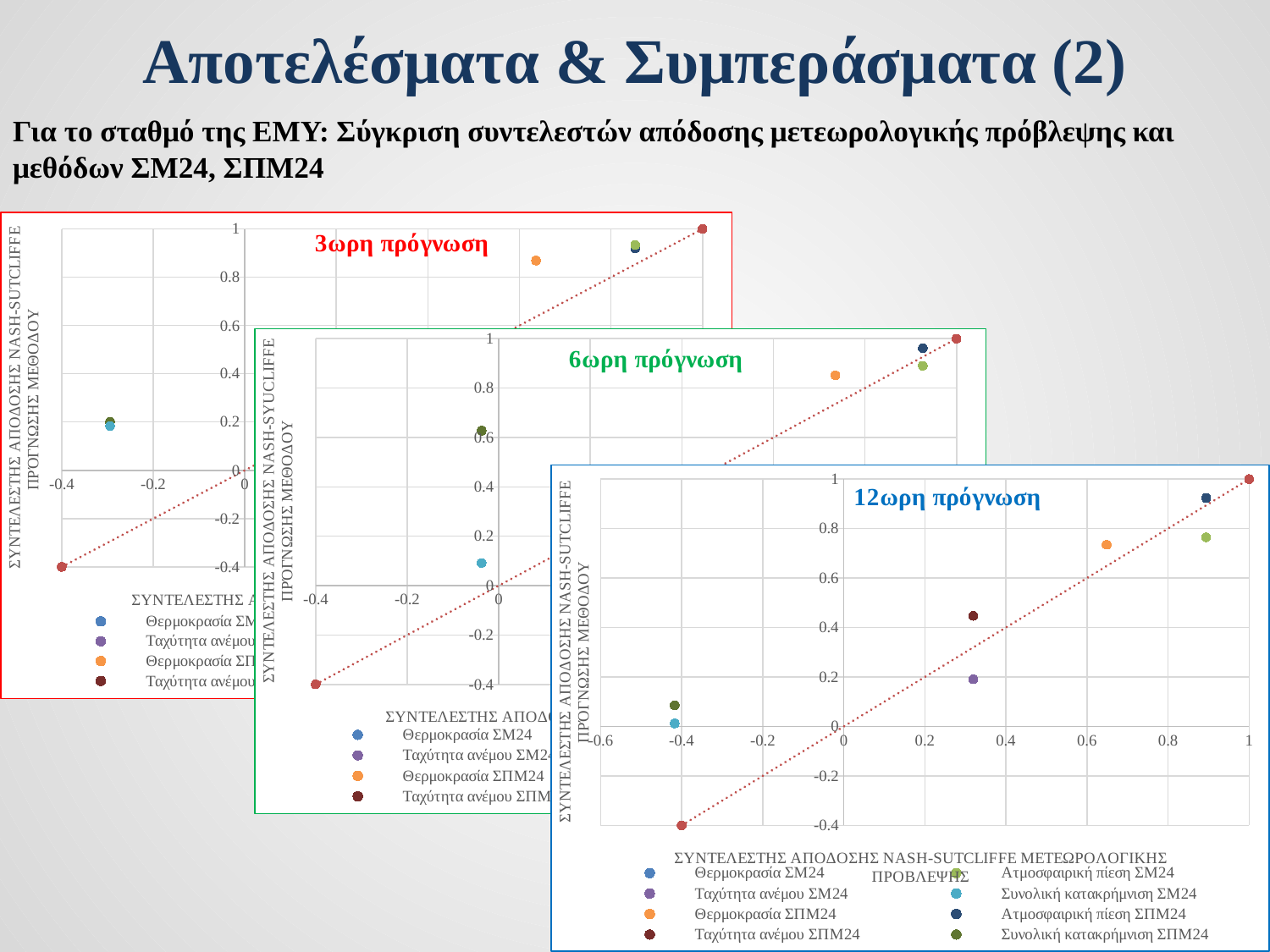
What is the highest value shown on the y-axis of the "12ωρη πρόγνωση" chart? 1 In the "6ωρη πρόγνωση" chart, is the y-axis value for Θερμοκρασία ΣΠΜ24 greater or less than 0.8? greater What is the x-axis title of the "12ωρη πρόγνωση" chart? ΣΥΝΤΕΛΕΣΤΗΣ ΑΠΟΔΟΣΗΣ NASH-SUTCLIFFE ΜΕΤΕΩΡΟΛΟΓΙΚΗΣ ΠΡΟΒΛΕΨΗΣ How many series does the legend of the "12ωρη πρόγνωση" chart list? 8 In the "12ωρη πρόγνωση" chart, is the y-axis value for Ταχύτητα ανέμου ΣΜ24 greater or less than 0.4? less In the "12ωρη πρόγνωση" chart, is the y-axis value for Θερμοκρασία ΣΠΜ24 greater or less than 0.6? greater What kind of chart is the "3ωρη πρόγνωση" chart? scatter chart How many charts are shown on the slide? 3 In the "12ωρη πρόγνωση" chart, which is higher on the y-axis: Θερμοκρασία ΣΠΜ24 or Ταχύτητα ανέμου ΣΜ24? Θερμοκρασία ΣΠΜ24